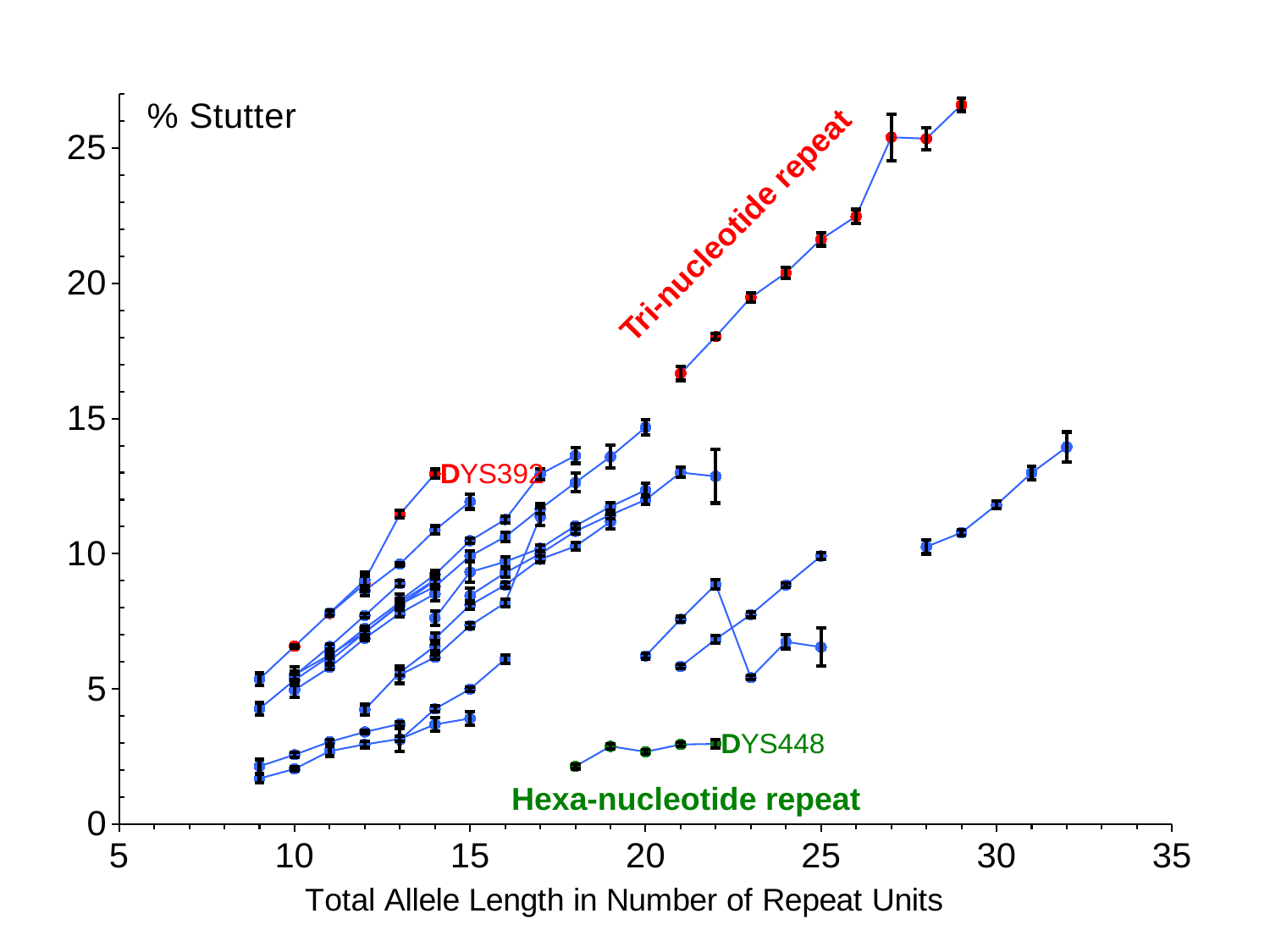
Which labelled series reaches the highest % Stutter values? Tri-nucleotide repeat What kind of chart is shown on the slide? line chart Is the % Stutter for DYS448 at 22 repeat units greater or less than 5? less Which labelled series has the lowest % Stutter values? Hexa-nucleotide repeat (DYS448) Does % Stutter for the Tri-nucleotide repeat series rise or fall as total allele length increases? rise Is the % Stutter for the Tri-nucleotide repeat series at 21 repeat units greater or less than 15? greater Is the % Stutter for the Tri-nucleotide repeat series at 29 repeat units greater or less than 25? greater What is the highest value labelled on the x axis? 35 What quantity is plotted on the y axis? % Stutter What is the label of the x axis? Total Allele Length in Number of Repeat Units